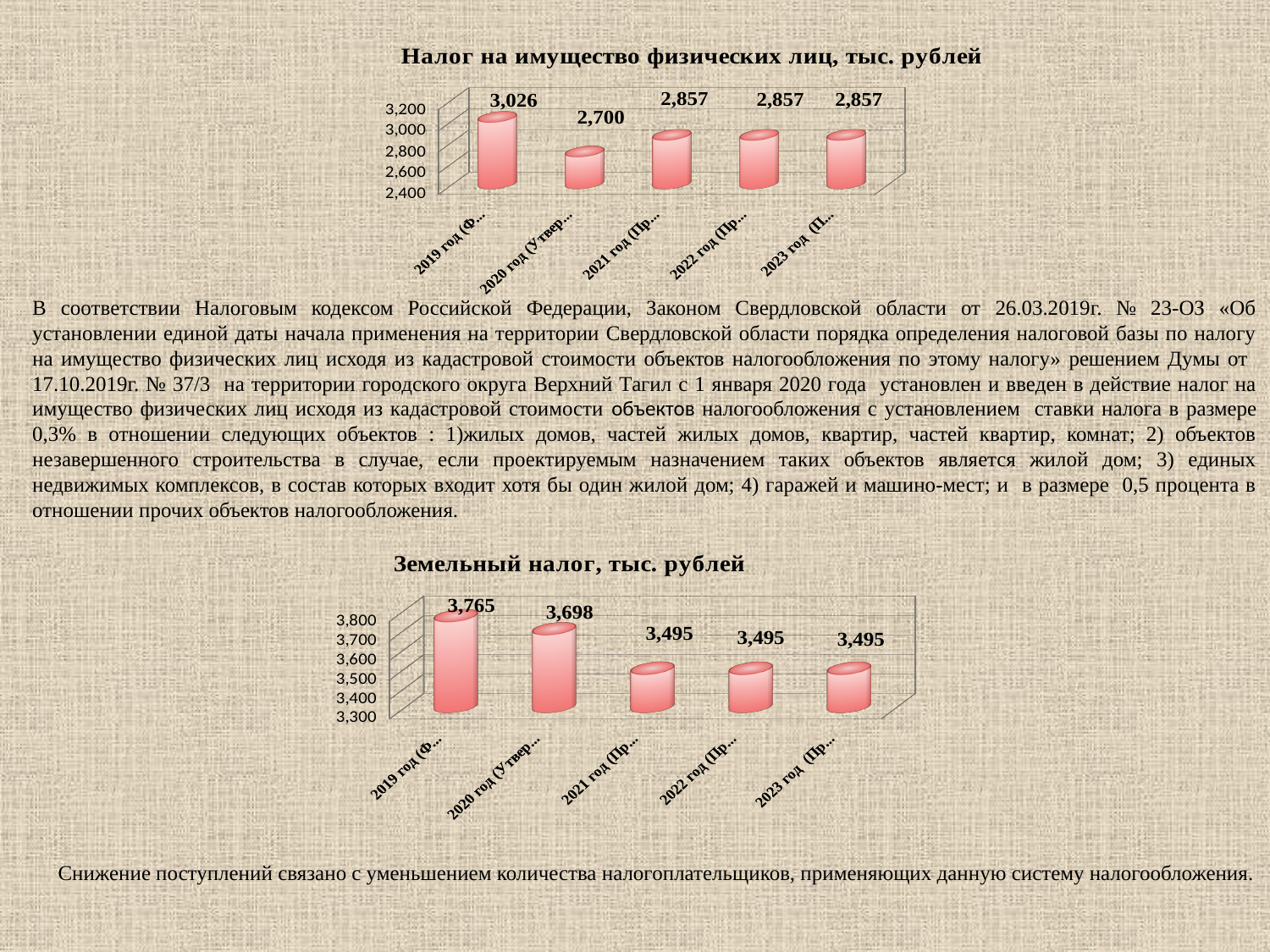
In the chart 'Налог на имущество физических лиц, тыс. рублей', which year has the lowest value? 2020 год In the chart 'Земельный налог, тыс. рублей', what is the difference between the 2020 год value and the 2021 год value? 203 In the chart 'Налог на имущество физических лиц, тыс. рублей', what is the difference between the 2019 год value and the 2020 год value? 326 In the chart 'Земельный налог, тыс. рублей', which year has the highest value? 2019 год In the chart 'Земельный налог, тыс. рублей', what is the value for 2019 год? 3,765 In the chart 'Налог на имущество физических лиц, тыс. рублей', what is the value for 2020 год? 2,700 In the chart 'Земельный налог, тыс. рублей', do the values generally rise or fall from 2019 год to 2023 год? fall What kind of chart is the bottom chart 'Земельный налог, тыс. рублей'? bar chart In the chart 'Налог на имущество физических лиц, тыс. рублей', how many bars are plotted? 5 In the chart 'Земельный налог, тыс. рублей', what is the value for 2021 год? 3,495 In the chart 'Налог на имущество физических лиц, тыс. рублей', what is the value for 2019 год? 3,026 In the chart 'Земельный налог, тыс. рублей', is the value for 2020 год larger or smaller than the value for 2022 год? larger